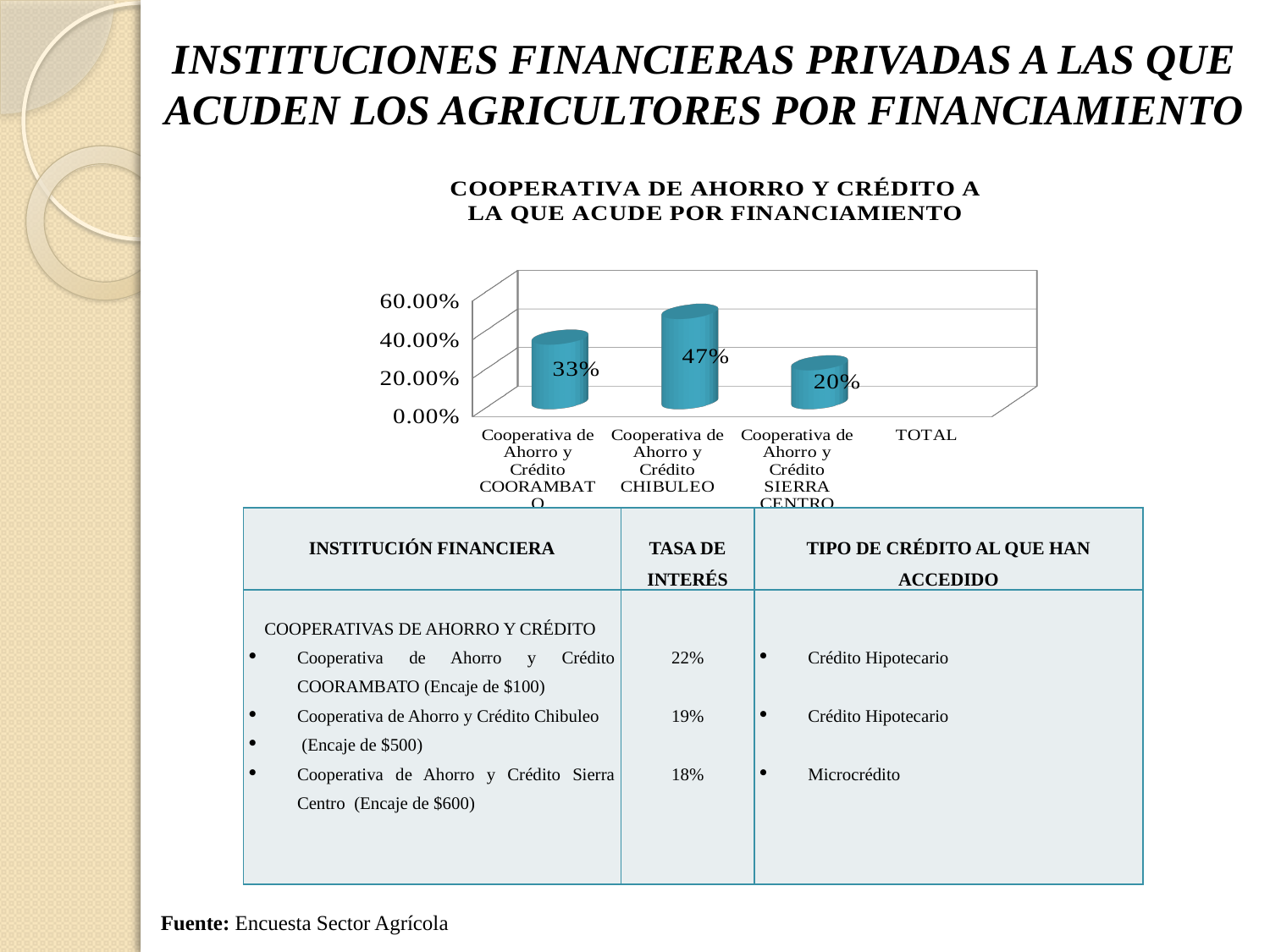
What is the title of the chart? COOPERATIVA DE AHORRO Y CRÉDITO A LA QUE ACUDE POR FINANCIAMIENTO Which is larger, the value for COORAMBATO or the value for SIERRA CENTRO? COORAMBATO What kind of chart is shown on the slide? Bar chart What is the difference between the values for CHIBULEO and COORAMBATO? 14% What is the value shown for Cooperativa de Ahorro y Crédito COORAMBATO? 33% Which cooperative has the lowest value in the chart? Cooperativa de Ahorro y Crédito SIERRA CENTRO Is the value for Cooperativa de Ahorro y Crédito CHIBULEO greater or less than 40.00%? greater What is the value shown for Cooperativa de Ahorro y Crédito SIERRA CENTRO? 20% How many bars are plotted in the chart? 3 Which cooperative has the highest value in the chart? Cooperativa de Ahorro y Crédito CHIBULEO What is the value shown for Cooperativa de Ahorro y Crédito CHIBULEO? 47% What is the difference between the values for COORAMBATO and SIERRA CENTRO? 13%